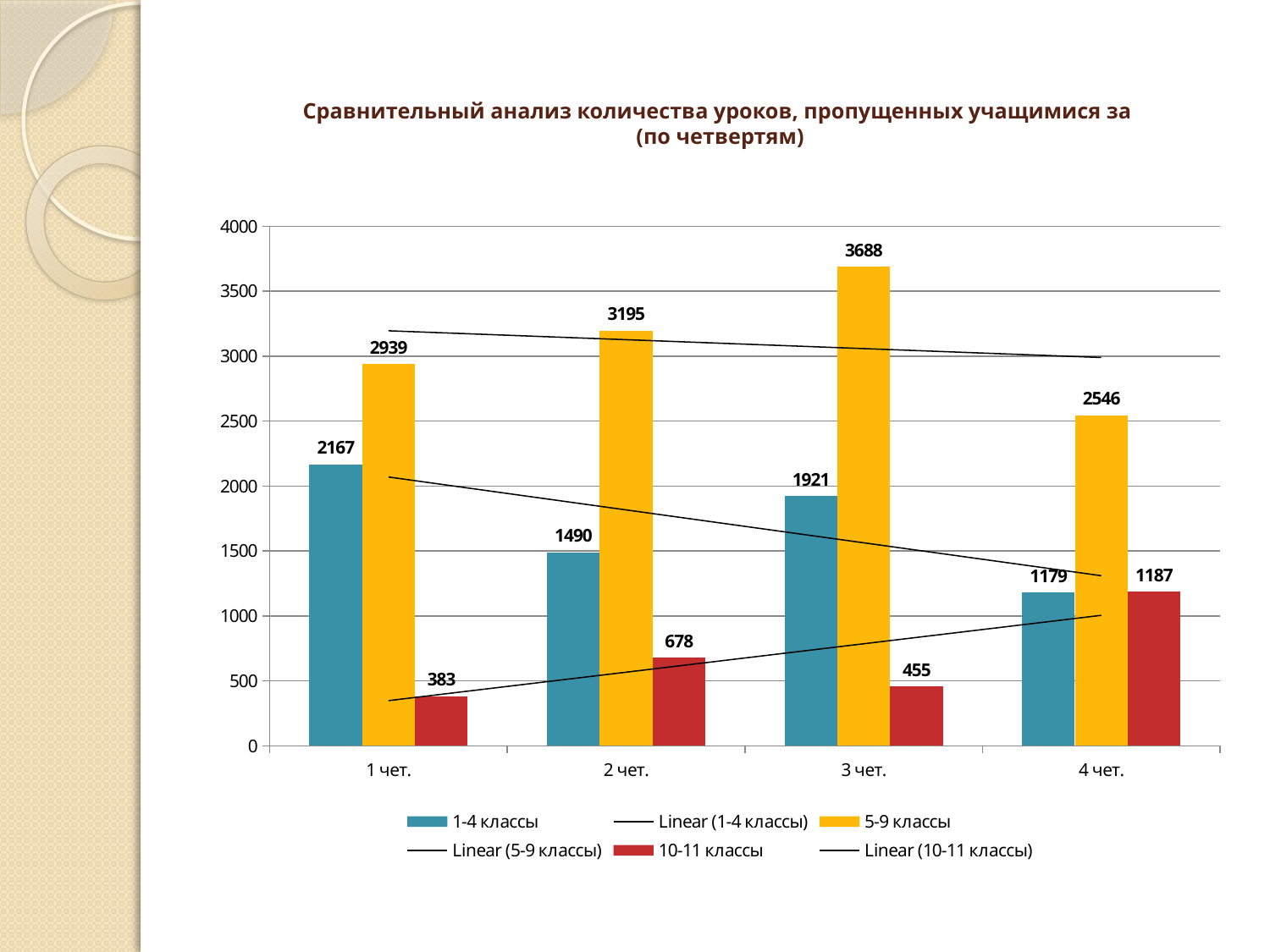
In which quarter is the value for 5-9 классы highest? 3 чет. What is the value for 1-4 классы in 1 чет.? 2167 Which is larger in 4 чет.: the value for 1-4 классы or for 10-11 классы? 10-11 классы What kind of chart is shown on the slide? bar chart What is the value for 10-11 классы in 4 чет.? 1187 How many quarters (categories) are shown on the x axis? 4 What is the difference between the 5-9 классы and 1-4 классы values in 2 чет.? 1705 What colour are the bars for 5-9 классы? yellow Does the value for 1-4 классы rise or fall from 1 чет. to 2 чет.? fall In which quarter is the value for 10-11 классы lowest? 1 чет. What is the value for 5-9 классы in 3 чет.? 3688 How many entries does the legend list? 6